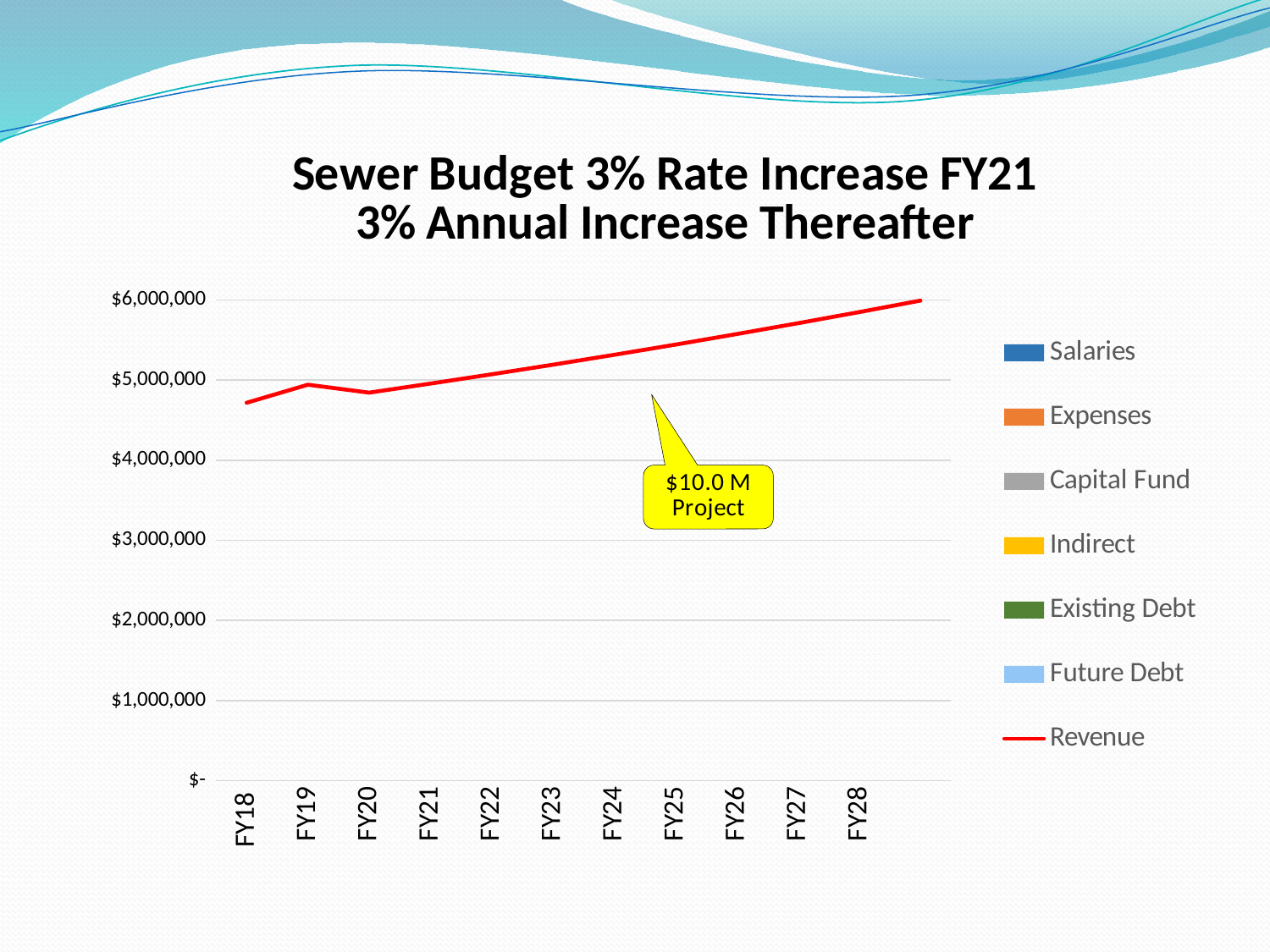
Is the Revenue value for FY26 greater or less than $5,000,000? greater Which fiscal year has the highest Revenue value? FY28 Does the Revenue line generally rise or fall from FY18 to FY28? rise Is the Revenue value for FY18 greater or less than $5,000,000? less Which is larger, the Revenue value for FY28 or for FY18? FY28 What does the yellow callout on the chart say? $10.0 M Project How many series does the legend list? 7 Which fiscal year has the lowest Revenue value? FY18 What is the title of the chart? Sewer Budget 3% Rate Increase FY21 3% Annual Increase Thereafter What is the first series listed in the legend? Salaries Is the Revenue value for FY24 greater or less than $5,000,000? greater How many fiscal years are shown on the x axis? 11